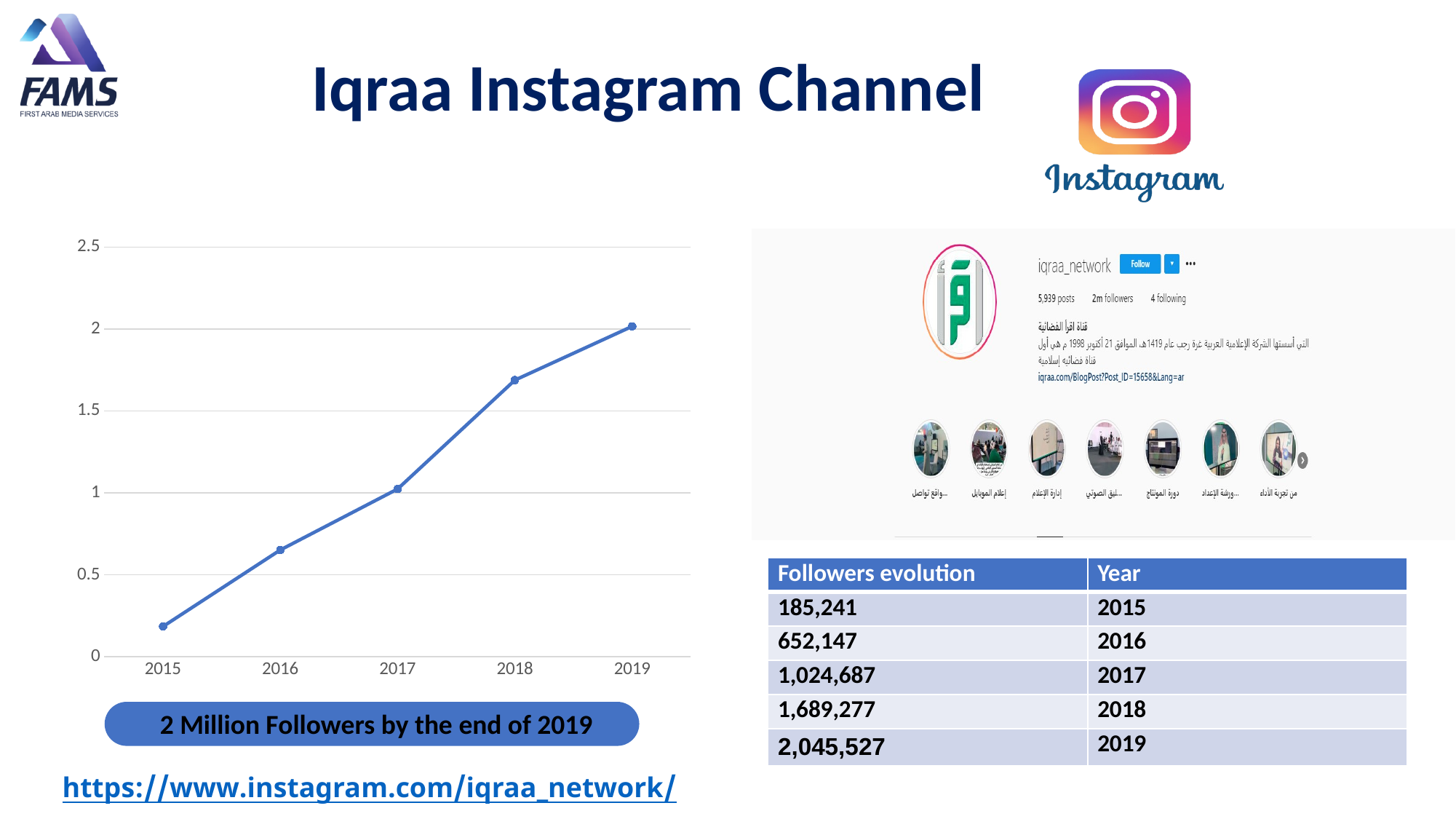
What is the first year shown on the x axis of the line chart? 2015 What is the highest tick value shown on the y axis of the line chart? 2.5 Do the values on the line chart rise or fall from 2015 to 2019? rise On the line chart, is the value for 2019 greater or less than 2.5? less On the line chart, is the value for 2015 greater or less than 0.5? less On the line chart, is the value for 2018 greater or less than 1.5? greater What kind of chart is shown on the left of the slide? line chart How many data points are plotted on the line chart? 5 Which year has the highest value on the line chart? 2019 On the line chart, which year has the larger value, 2016 or 2017? 2017 Which year has the lowest value on the line chart? 2015